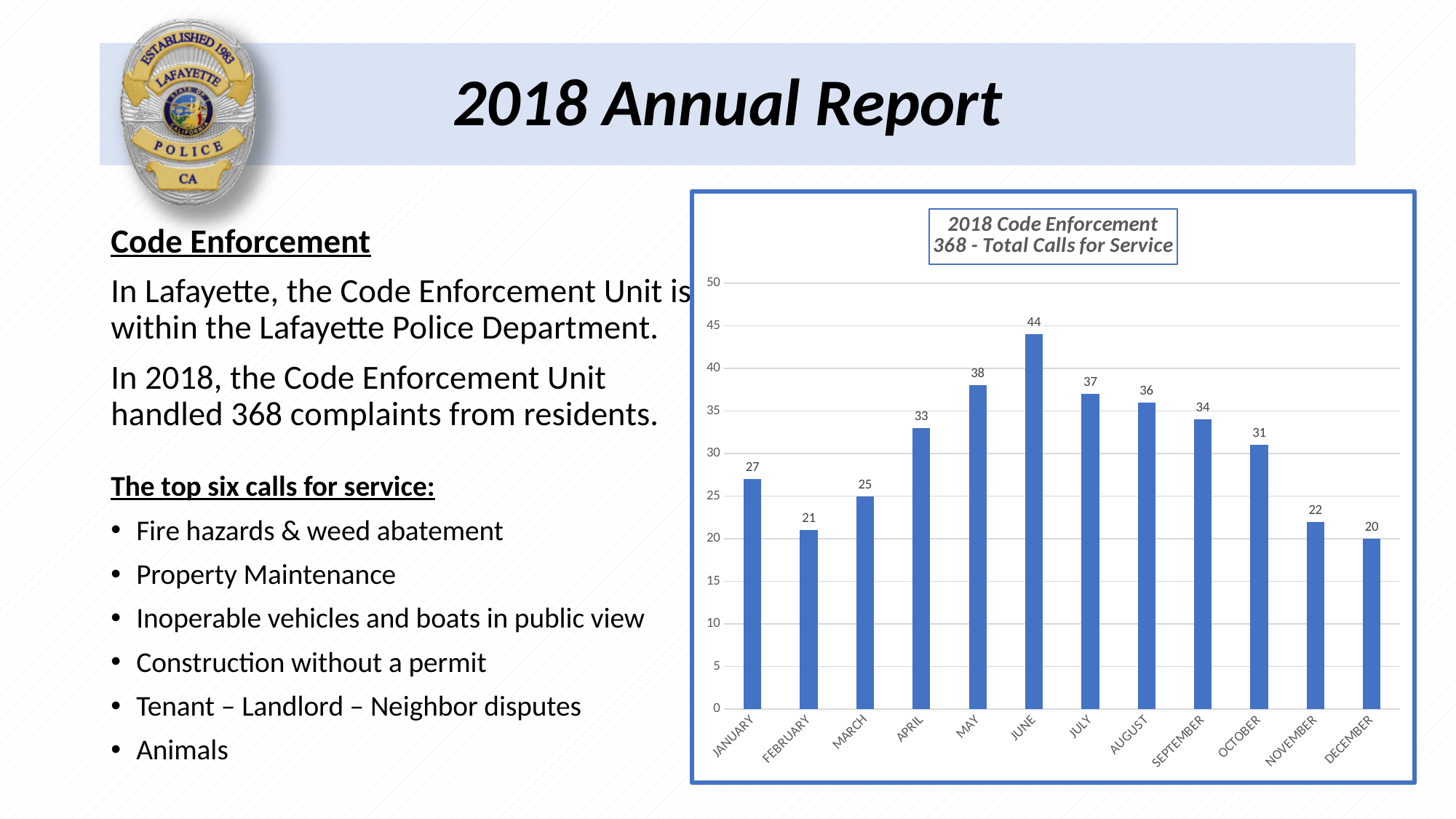
What is the value for October in the 2018 Code Enforcement chart? 31 What is the difference between the values for June and December in the 2018 Code Enforcement chart? 24 What is the value for February in the 2018 Code Enforcement chart? 21 Which month has the lowest value in the 2018 Code Enforcement chart? December Is the value for March in the 2018 Code Enforcement chart greater or less than 30? less What is the value for June in the 2018 Code Enforcement chart? 44 What kind of chart is the 2018 Code Enforcement chart? bar chart How many months are shown in the 2018 Code Enforcement chart? 12 What is the difference between the values for May and April in the 2018 Code Enforcement chart? 5 Which month has the highest value in the 2018 Code Enforcement chart? June Which is larger in the 2018 Code Enforcement chart, the value for July or the value for September? July What total number of calls for service does the title of the 2018 Code Enforcement chart state? 368